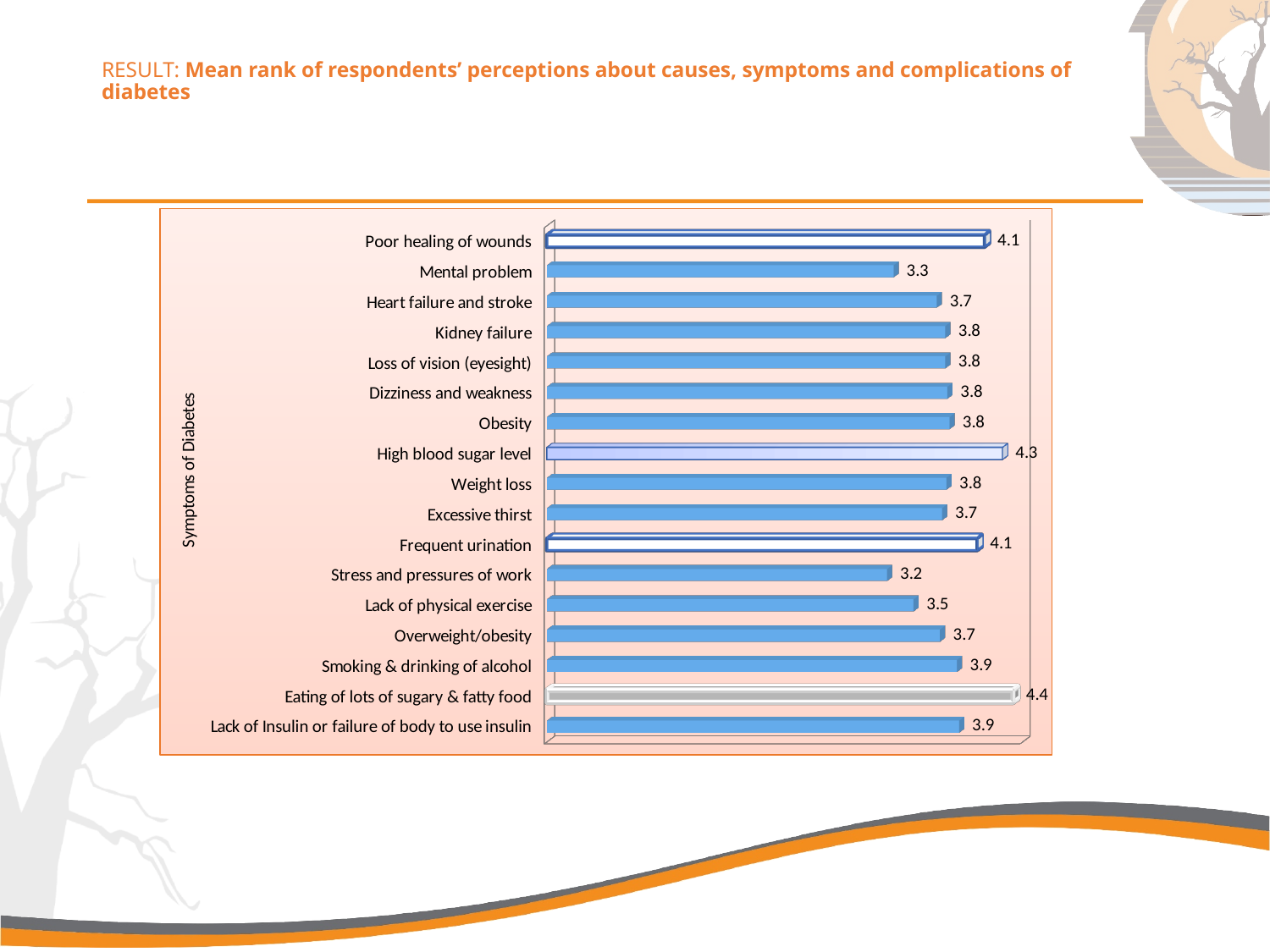
What kind of chart is shown on the slide? Bar chart What is the mean rank for Mental problem? 3.3 What is the mean rank for Frequent urination? 4.1 What is the difference between the mean rank for High blood sugar level and the mean rank for Mental problem? 1.0 What is the mean rank for Lack of physical exercise? 3.5 Which category has the highest mean rank? Eating of lots of sugary & fatty food Which has a higher mean rank, Smoking & drinking of alcohol or Overweight/obesity? Smoking & drinking of alcohol What is the mean rank for Eating of lots of sugary & fatty food? 4.4 Which category has the lowest mean rank? Stress and pressures of work How many categories are shown in the chart? 17 What is the mean rank for Poor healing of wounds? 4.1 What is the label on the vertical axis of the chart? Symptoms of Diabetes